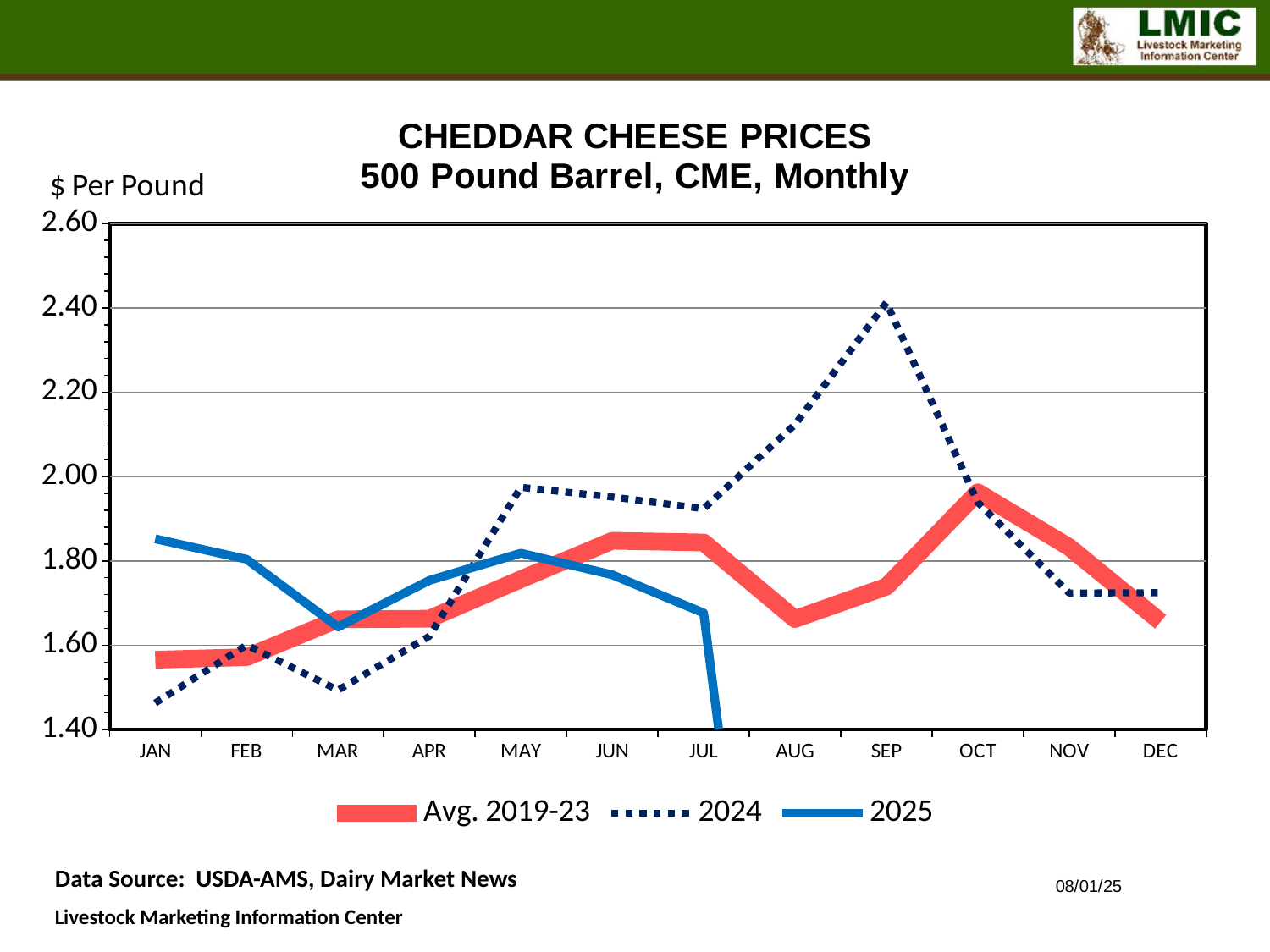
Is the 2024 value for SEP greater or less than 2.20? greater In which month does the Avg. 2019-23 series reach its highest value? OCT In which month does the 2024 series reach its highest value? SEP Does the 2024 series rise or fall from JUL to SEP? rise In SEP, which series has the larger value: 2024 or Avg. 2019-23? 2024 How many series does the legend list? 3 Is the 2025 value for JAN greater or less than 1.80? greater What kind of chart is shown on the slide? line chart In MAR, which series has the larger value: 2025 or 2024? 2025 Is the Avg. 2019-23 value for AUG greater or less than 1.80? less How many months are shown along the x axis? 12